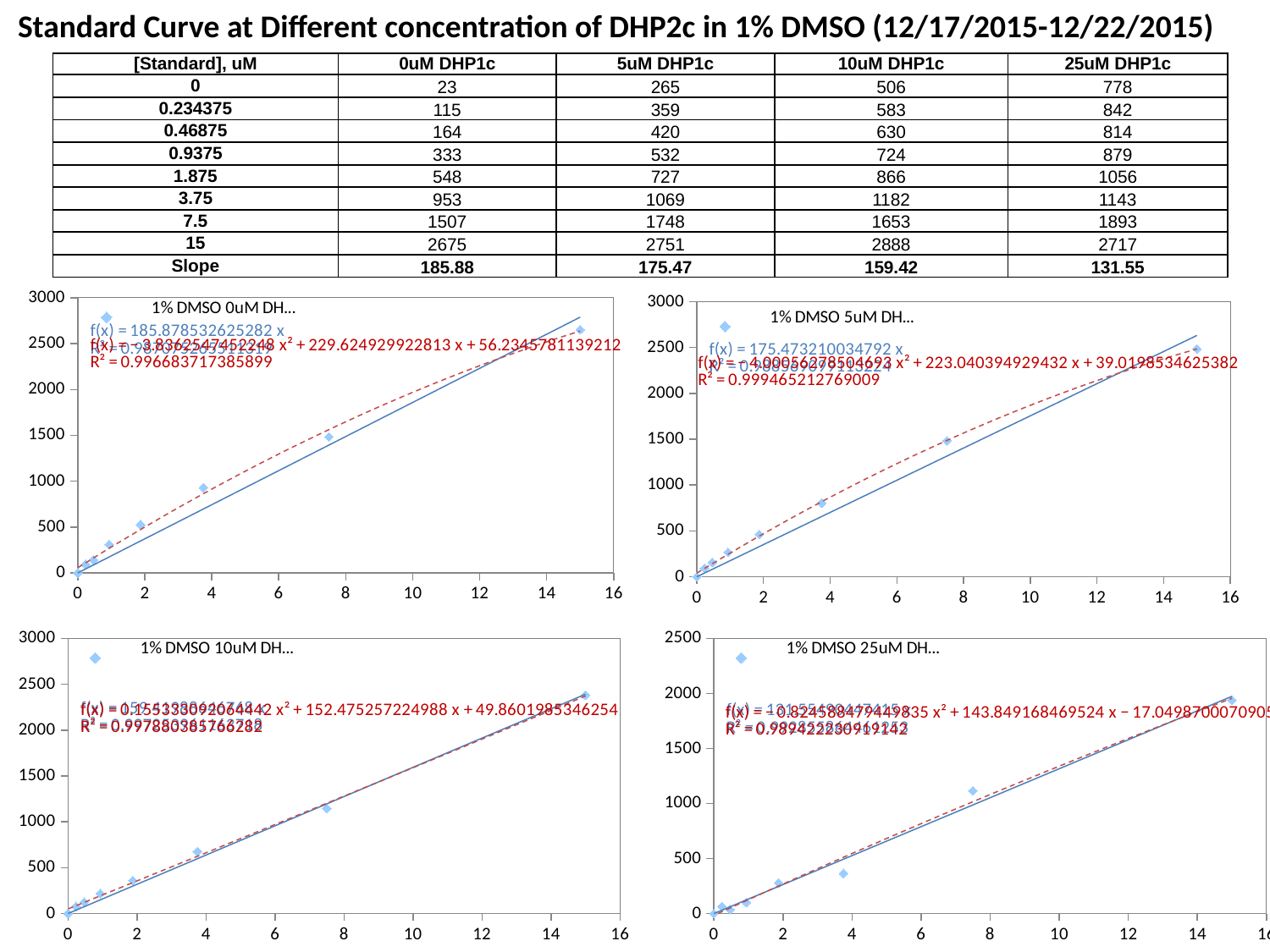
In the bottom-right chart (1% DMSO 25uM DH...), is the value at x = 3.75 greater or less than 500? less In the top-left chart (1% DMSO 0uM DH...), how many data points are plotted? 8 In the bottom-left chart (1% DMSO 10uM DH...), is the value at x = 15 greater or less than 2000? greater In the top-right chart (1% DMSO 5uM DH...), is the value at x = 7.5 greater or less than 1000? greater In the top-right chart (1% DMSO 5uM DH...), is the value at x = 1.875 larger or smaller than the value at x = 15? smaller In the bottom-left chart (1% DMSO 10uM DH...), do the plotted values rise or fall as x increases? rise What is the linear trendline equation printed on the top-left chart (1% DMSO 0uM DH...)? f(x) = 185.878532625282 x In the top-left chart (1% DMSO 0uM DH...), is the value at x = 7.5 larger or smaller than the value at x = 3.75? larger What kind of chart is the top-left chart (1% DMSO 0uM DH...)? scatter chart What is the linear trendline equation printed on the top-right chart (1% DMSO 5uM DH...)? f(x) = 175.473210034792 x How many charts are shown on the slide? 4